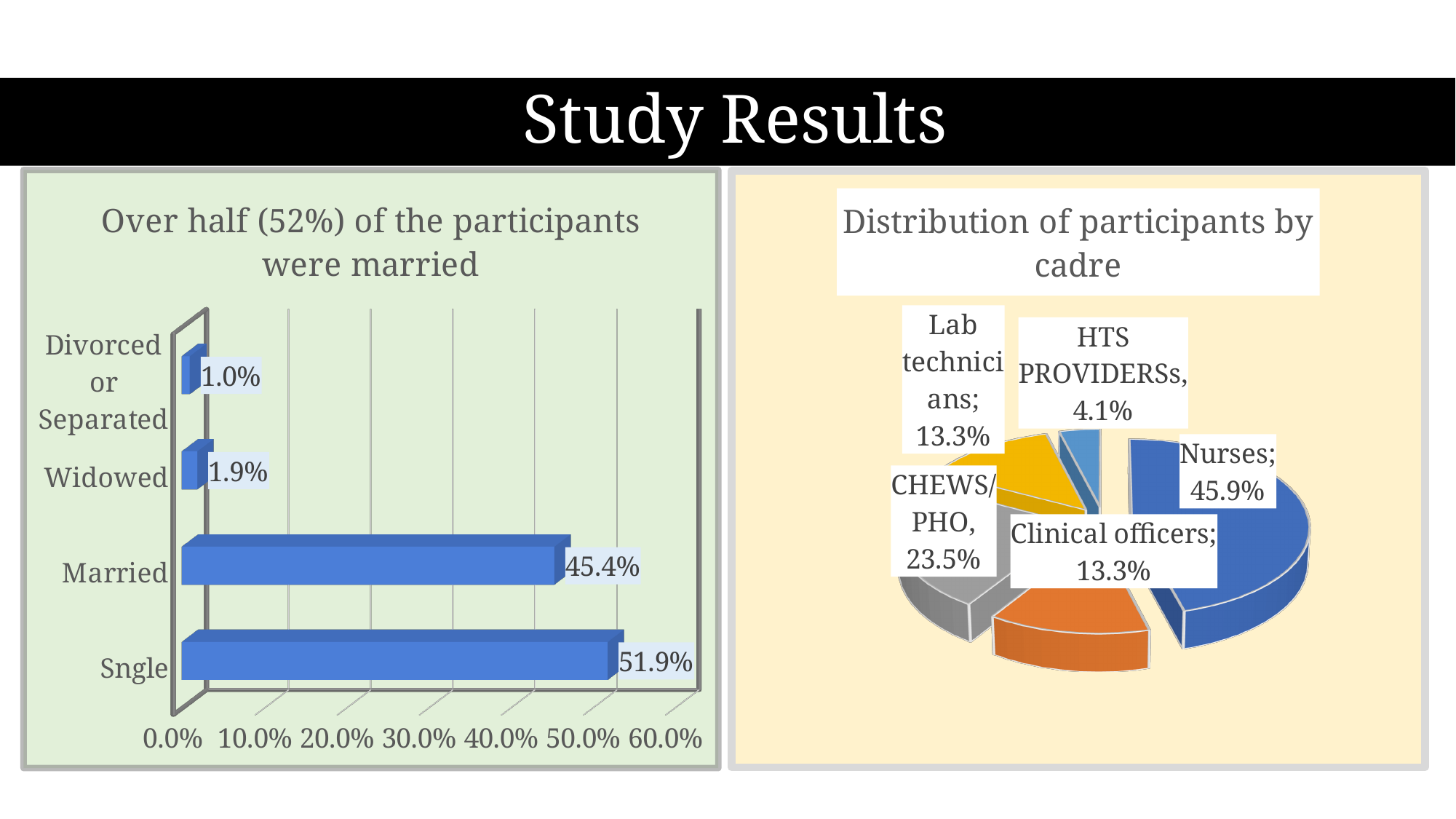
In the left bar chart, what percentage of participants were Married? 45.4% What kind of chart is the chart on the left of the slide? Bar chart How many categories are shown in the left bar chart? 4 In the 'Distribution of participants by cadre' pie chart, what is the value for CHEWS/PHO? 23.5% In the 'Distribution of participants by cadre' pie chart, what share are Nurses? 45.9% How many slices does the 'Distribution of participants by cadre' pie chart have? 5 In the left bar chart, what is the difference between the Single and Married values? 6.5% In the left bar chart, which marital status category has the lowest value? Divorced or Separated In the left bar chart, what is the value for Widowed? 1.9% In the 'Distribution of participants by cadre' pie chart, which cadre has the largest share? Nurses In the left bar chart, which marital status category has the highest value? Single In the 'Distribution of participants by cadre' pie chart, which cadre has the smallest share? HTS PROVIDERSs